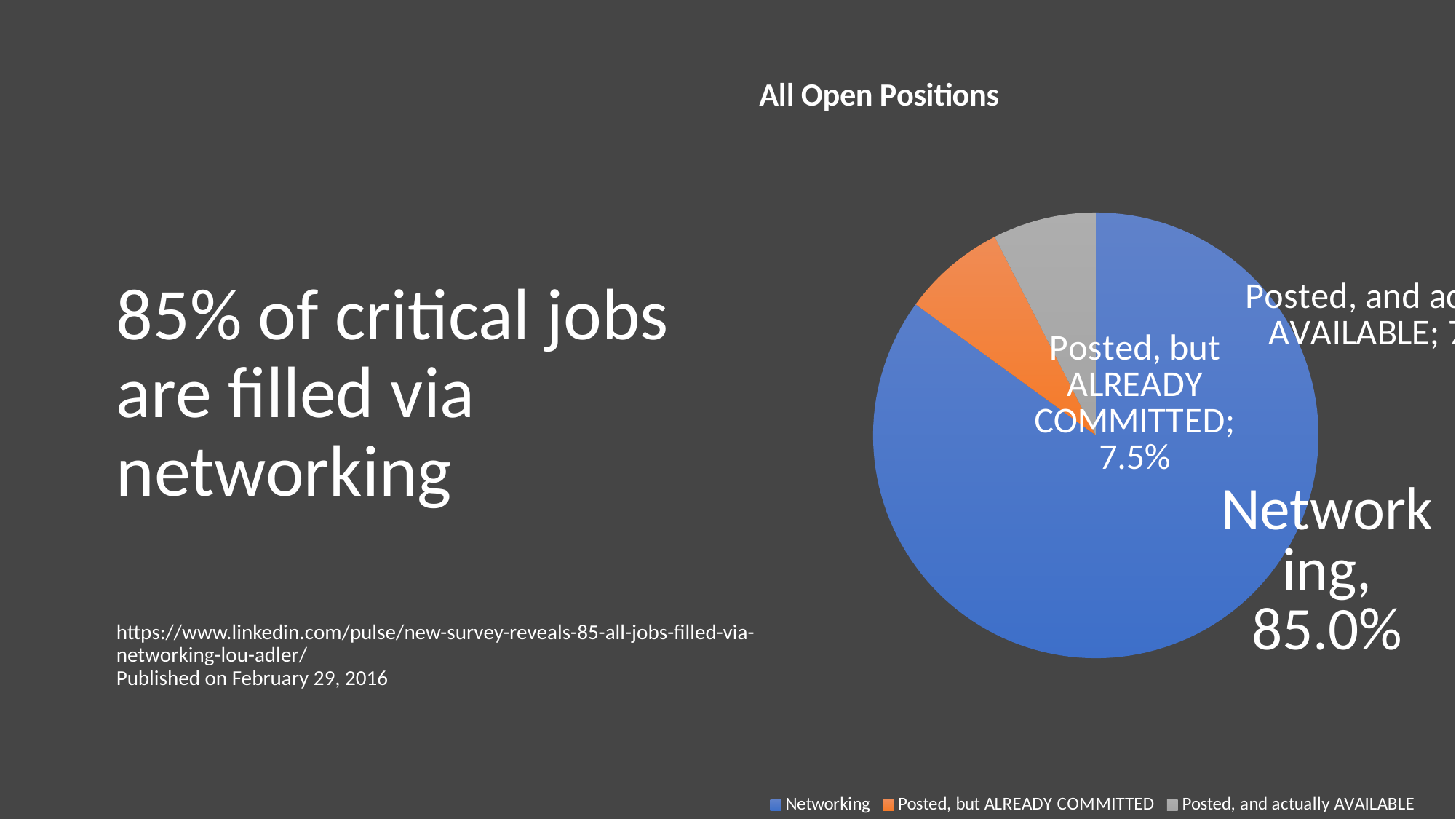
Which category has the largest slice of the pie? Networking Which is larger: the Networking slice or the 'Posted, but ALREADY COMMITTED' slice? Networking What is the difference in percentage points between the Networking slice and the 'Posted, but ALREADY COMMITTED' slice? 77.5% What is the title of the chart? All Open Positions How many entries does the chart legend list? 3 What kind of chart is shown on the slide? pie chart What colour is the Networking slice in the pie chart? blue What share of the pie does the Networking slice represent? 85.0% What percentage of all open positions is labelled 'Posted, but ALREADY COMMITTED'? 7.5% What percentage of all open positions is attributed to Networking? 85.0% How many slices does the pie chart have? 3